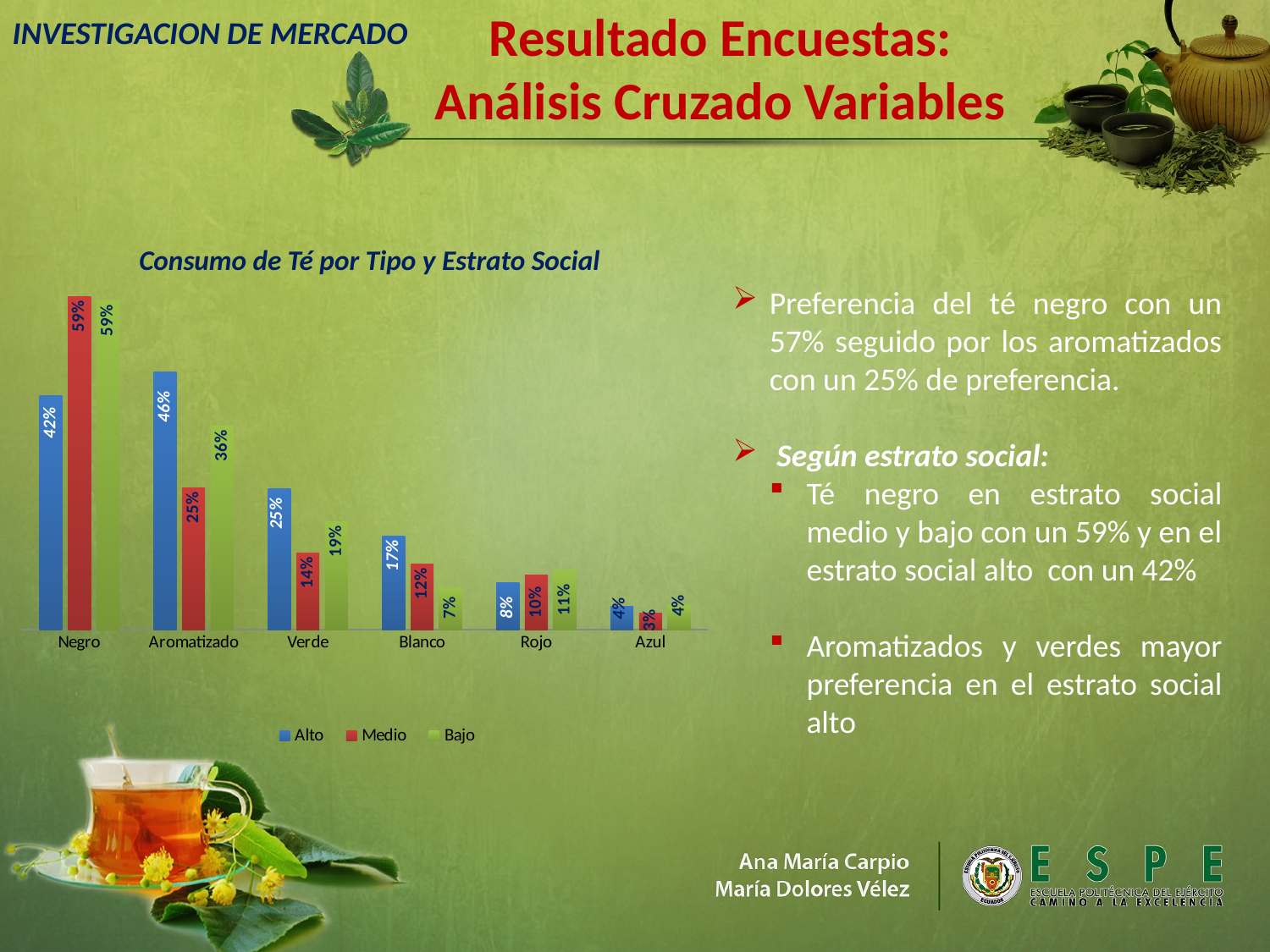
What is the value for Bajo in the Aromatizado category? 36% What kind of chart is shown on the slide? Bar chart What is the value for Bajo in the Blanco category? 7% How many tea type categories are shown on the x axis? 6 What is the value for Alto in the Negro category? 42% Which category has the lowest value for the Medio series? Azul Which category has the highest value for the Alto series? Aromatizado How many series does the legend list? 3 Which is larger in the Rojo category, Alto or Bajo? Bajo What is the title of the chart? Consumo de Té por Tipo y Estrato Social What is the value for Medio in the Verde category? 14% What is the difference between the Medio and Alto values in the Negro category? 17%